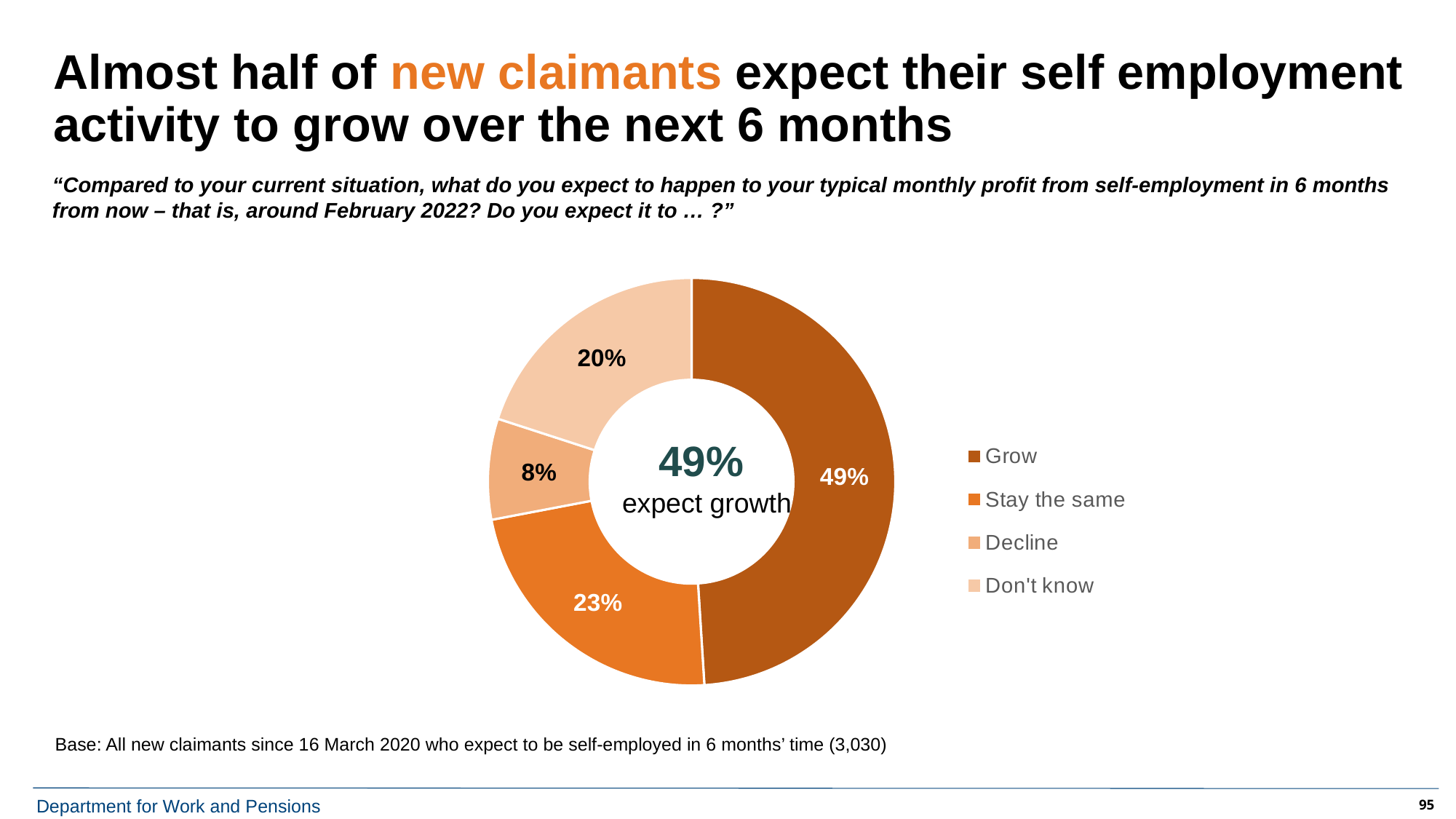
What percentage of new claimants expect their self-employment profit to stay the same? 23% How many response categories are shown in the chart? 4 What percentage of new claimants answered 'Don't know'? 20% What kind of chart is shown on the slide? Pie chart (doughnut) What is the difference in percentage points between 'Grow' and 'Stay the same'? 26 Which response category has the smallest share of the chart? Decline What is the difference in percentage points between 'Don't know' and 'Decline'? 12 What percentage of new claimants expect their self-employment profit to decline? 8% Which response category has the largest share of the chart? Grow Which is larger, the share for 'Stay the same' or the share for 'Don't know'? Stay the same What percentage of new claimants expect their self-employment profit to grow? 49% What text is shown in the centre of the doughnut chart? 49% expect growth